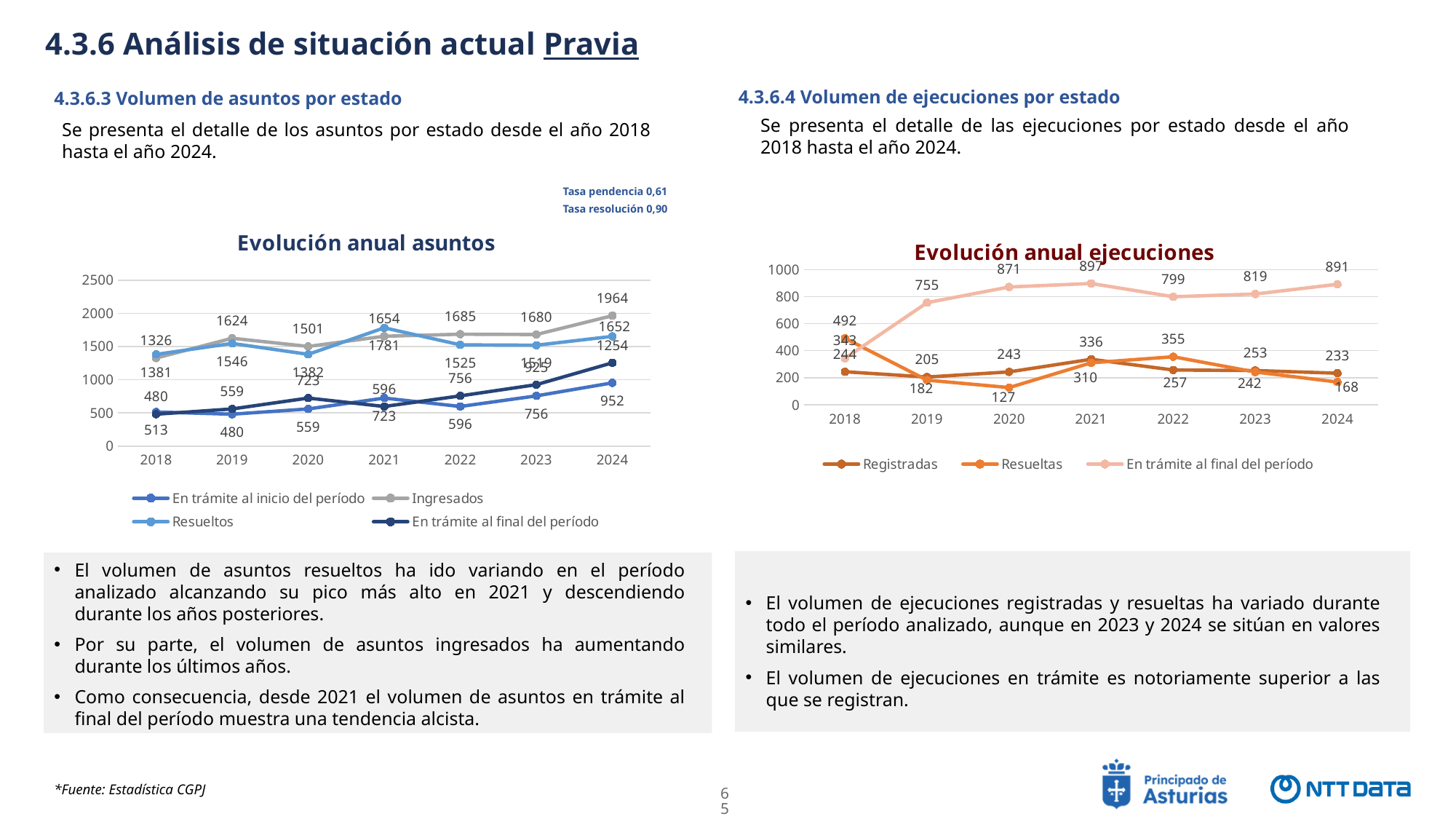
In the 'Evolución anual asuntos' chart, what is the value of 'En trámite al final del período' in 2024? 1254 In the 'Evolución anual asuntos' chart, what is the difference between Ingresados in 2024 and in 2023? 284 How many series does the legend of the 'Evolución anual asuntos' chart list? 4 In the 'Evolución anual asuntos' chart, what is the value of Resueltos in 2021? 1781 In the 'Evolución anual ejecuciones' chart, which is larger in 2024: 'En trámite al final del período' or Registradas? En trámite al final del período What kind of chart is 'Evolución anual ejecuciones'? Line chart In the 'Evolución anual asuntos' chart, in which year is Ingresados highest? 2024 In the 'Evolución anual ejecuciones' chart, does 'En trámite al final del período' rise or fall from 2018 to 2021? Rise In the 'Evolución anual asuntos' chart, what is the value of Ingresados in 2024? 1964 How many years are shown on the x axis of the 'Evolución anual ejecuciones' chart? 7 In the 'Evolución anual ejecuciones' chart, in which year is Resueltas lowest? 2020 In the 'Evolución anual ejecuciones' chart, what is the value of 'En trámite al final del período' in 2021? 897